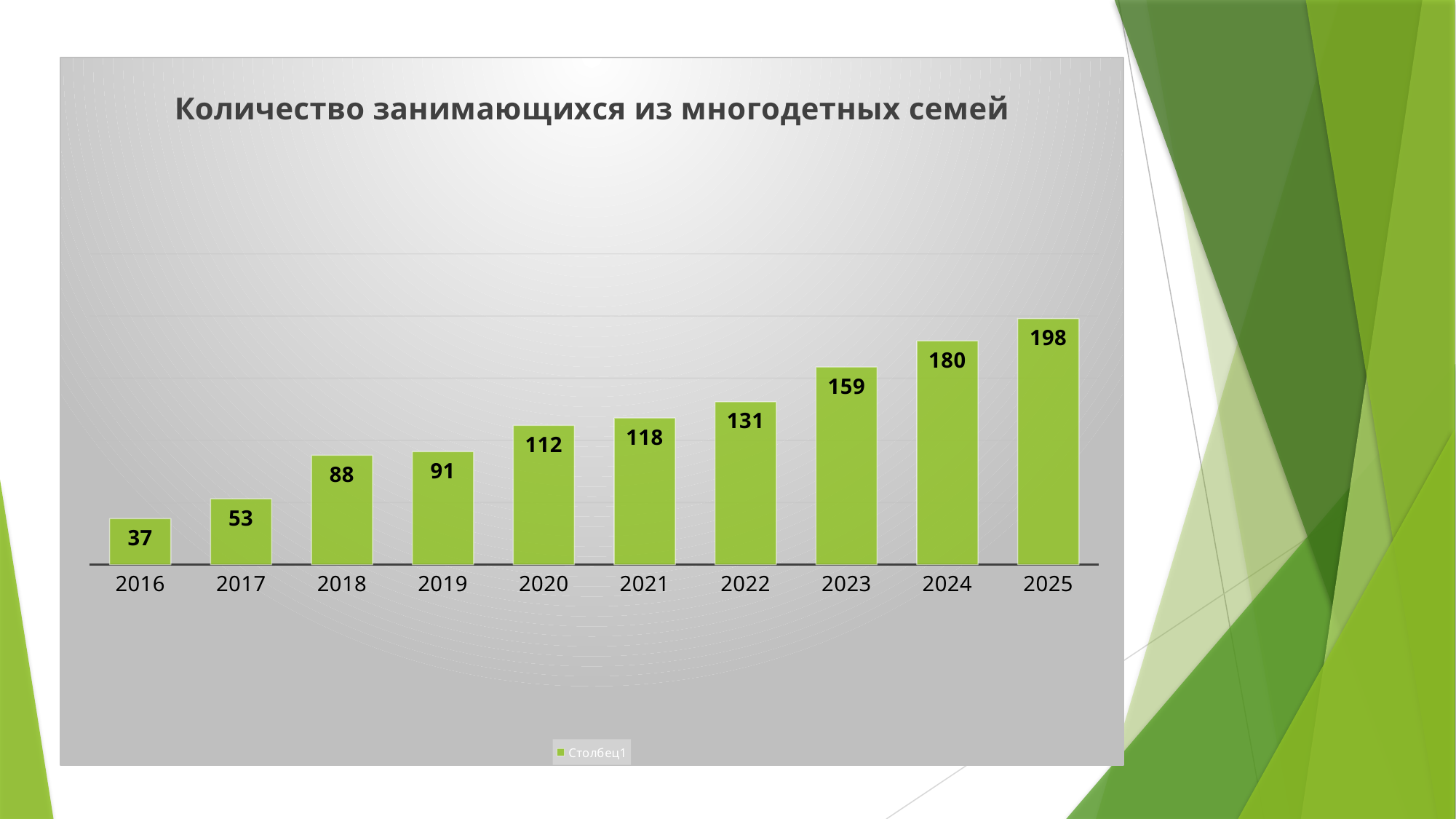
What is the value for 2016? 37 Do the values rise or fall from 2016 to 2025? rise What is the difference between the values for 2018 and 2017? 35 What kind of chart is this? bar chart What is the value for 2020? 112 What is the value for 2023? 159 How many years are shown on the x axis? 10 Which is larger, the value for 2019 or the value for 2021? 2021 Which year has the highest value? 2025 How many series does the legend list? 1 What is the difference between the values for 2025 and 2024? 18 Which year has the lowest value? 2016